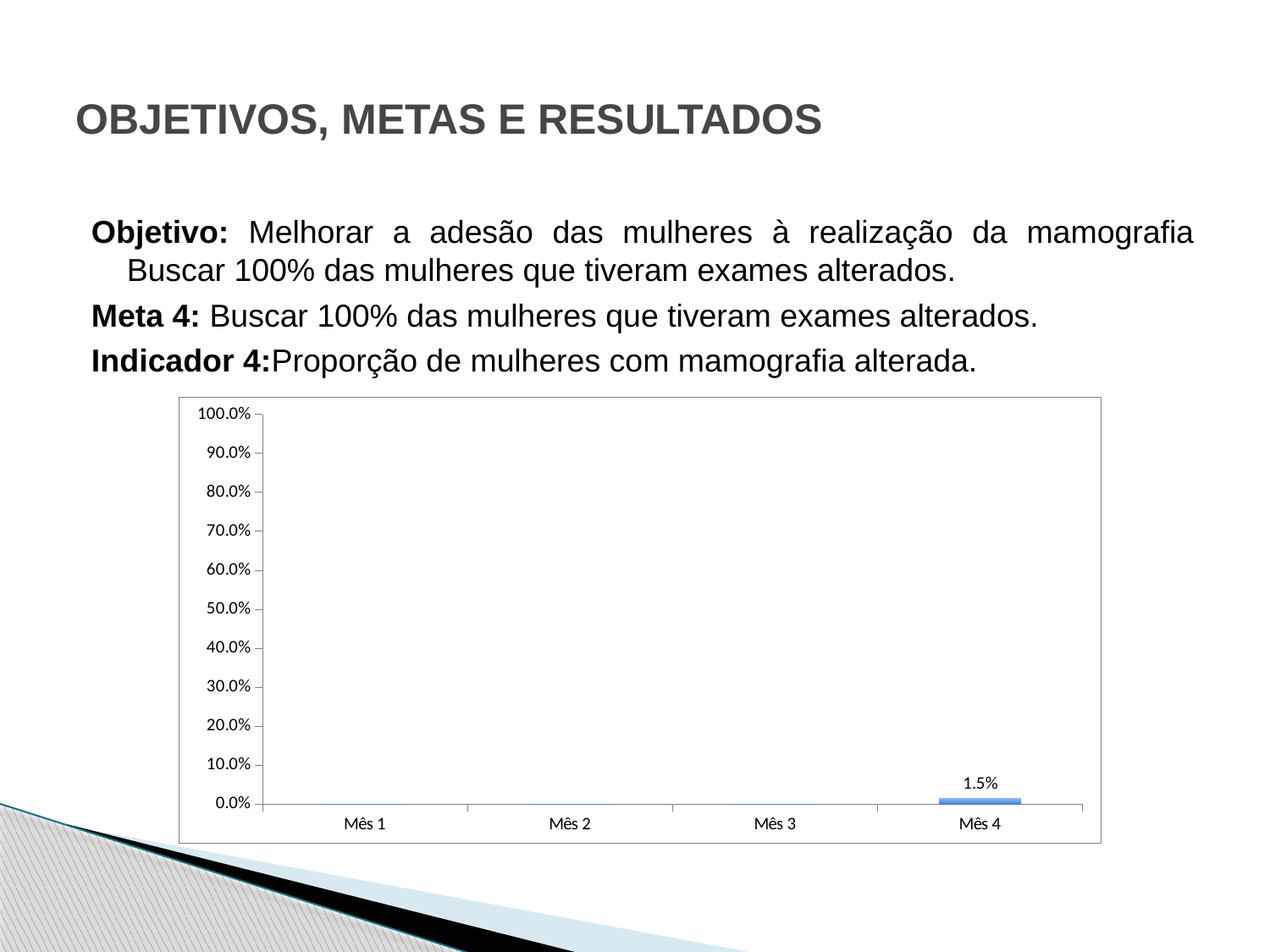
What is the value for Mês 4? 1.5% How many months are shown on the x axis? 4 Which month has the highest value? Mês 4 What is the highest value shown on the y axis? 100.0% Is the value for Mês 2 greater or less than 10.0%? less Is the value for Mês 4 greater or less than 10.0%? less Which month is the only one with a printed data label? Mês 4 Which is larger, the value for Mês 1 or the value for Mês 4? Mês 4 What kind of chart is shown on the slide? Bar chart